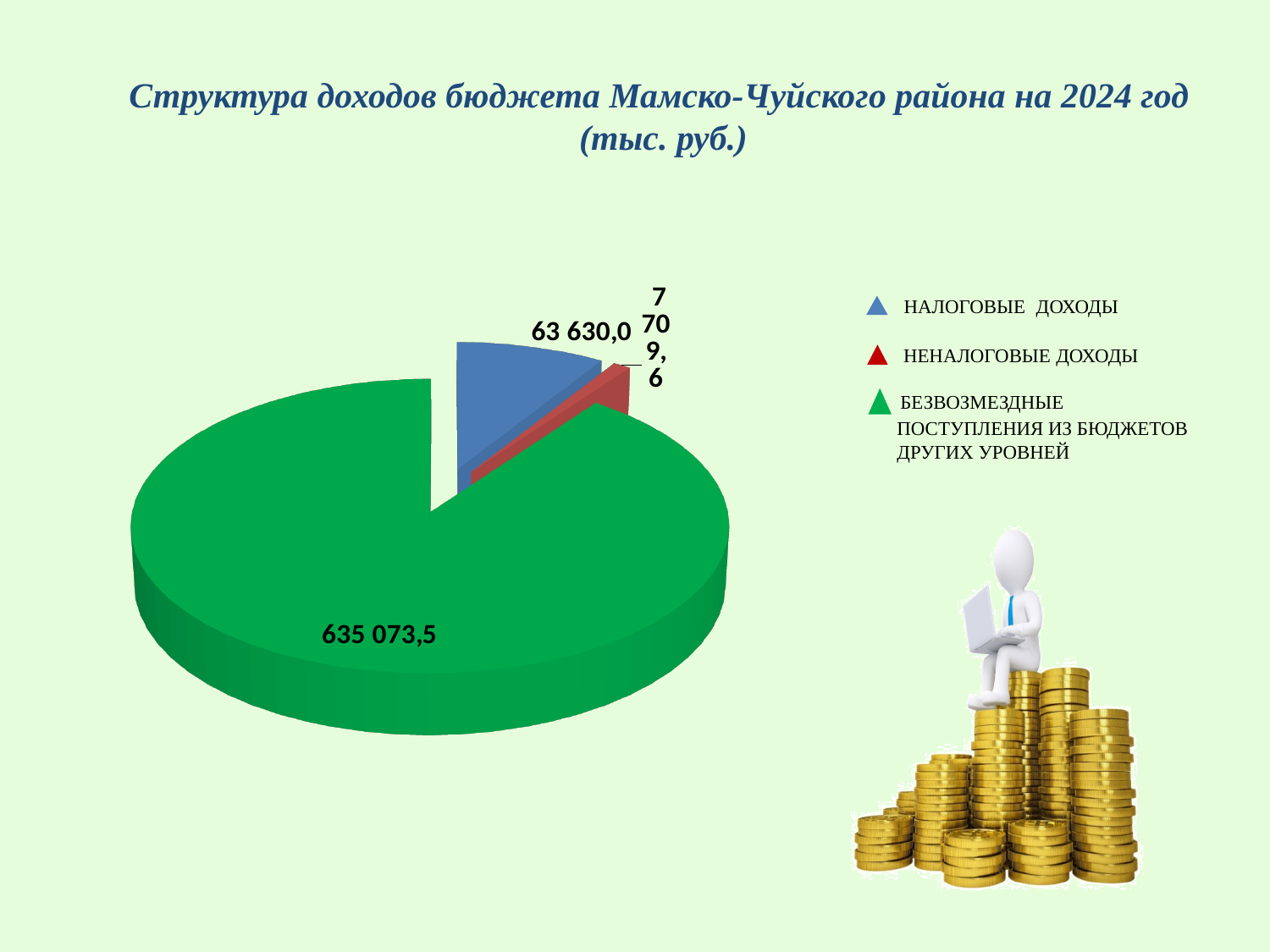
What colour is the slice for НАЛОГОВЫЕ ДОХОДЫ? blue What is the title of the chart? Структура доходов бюджета Мамско-Чуйского района на 2024 год (тыс. руб.) What is the value for БЕЗВОЗМЕЗДНЫЕ ПОСТУПЛЕНИЯ ИЗ БЮДЖЕТОВ ДРУГИХ УРОВНЕЙ? 635 073,5 Which category has the largest slice of the pie? БЕЗВОЗМЕЗДНЫЕ ПОСТУПЛЕНИЯ ИЗ БЮДЖЕТОВ ДРУГИХ УРОВНЕЙ What is the value for НЕНАЛОГОВЫЕ ДОХОДЫ? 7 709,6 How many slices does the pie chart have? 3 Which is larger, НАЛОГОВЫЕ ДОХОДЫ or НЕНАЛОГОВЫЕ ДОХОДЫ? НАЛОГОВЫЕ ДОХОДЫ What is the value for НАЛОГОВЫЕ ДОХОДЫ? 63 630,0 What is the difference between the value for БЕЗВОЗМЕЗДНЫЕ ПОСТУПЛЕНИЯ ИЗ БЮДЖЕТОВ ДРУГИХ УРОВНЕЙ and the value for НАЛОГОВЫЕ ДОХОДЫ? 571 443,5 What kind of chart is shown on the slide? pie chart Which category has the smallest slice of the pie? НЕНАЛОГОВЫЕ ДОХОДЫ How many entries does the legend list? 3